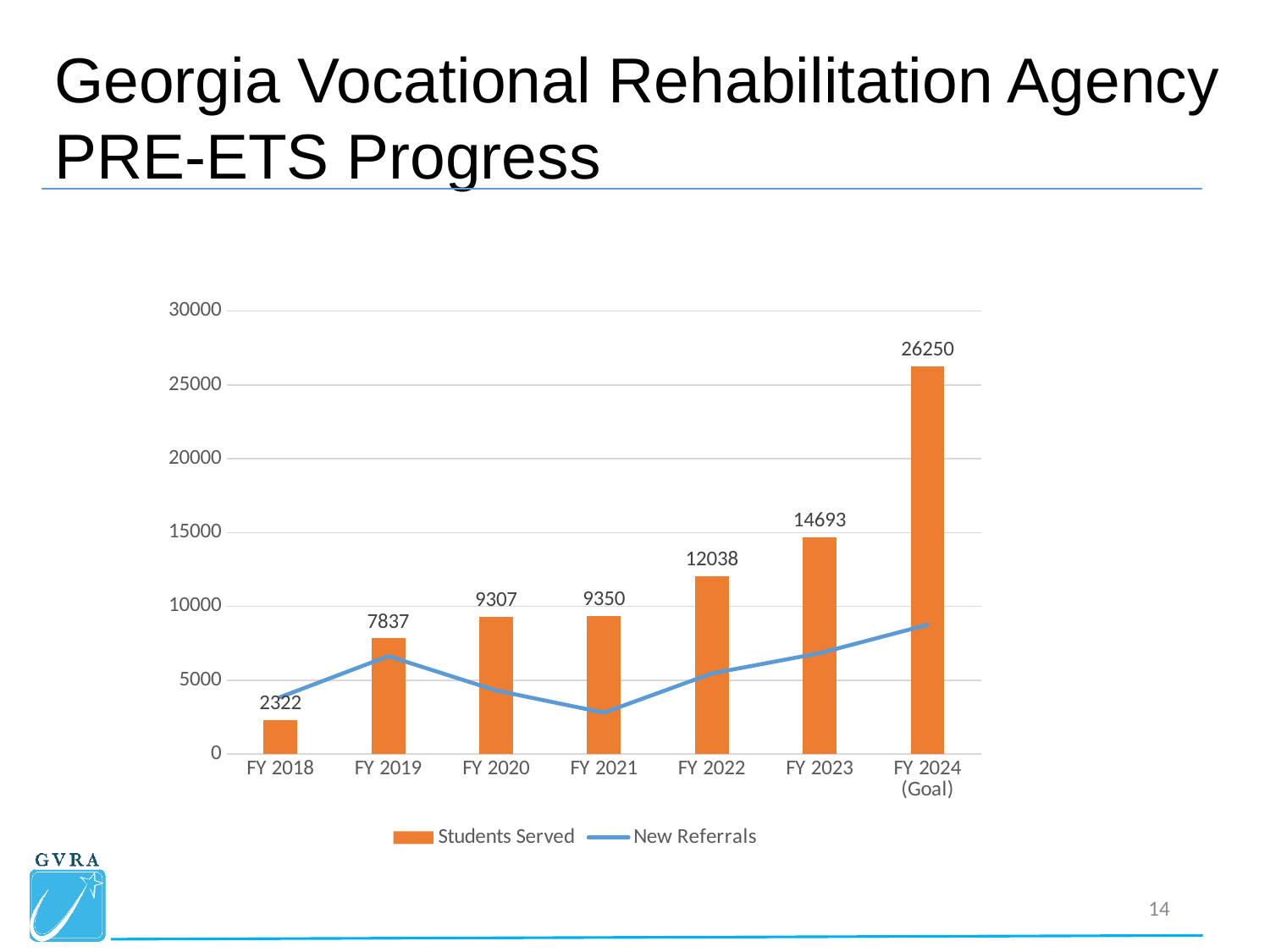
How many series does the legend list? 2 What is the difference in Students Served between FY 2023 and FY 2022? 2655 Do the Students Served values rise or fall from FY 2018 to FY 2024 (Goal)? rise How many fiscal years are shown on the x axis? 7 Is the New Referrals value for FY 2021 greater or less than 5000? less What is the value of Students Served for FY 2018? 2322 What is the Students Served goal shown for FY 2024? 26250 Which fiscal year has the highest Students Served value? FY 2024 (Goal) Which fiscal year has the lowest Students Served value? FY 2018 What is the value of Students Served for FY 2022? 12038 Is the New Referrals value for FY 2019 greater or less than 5000? greater Which is larger, Students Served in FY 2019 or in FY 2020? FY 2020